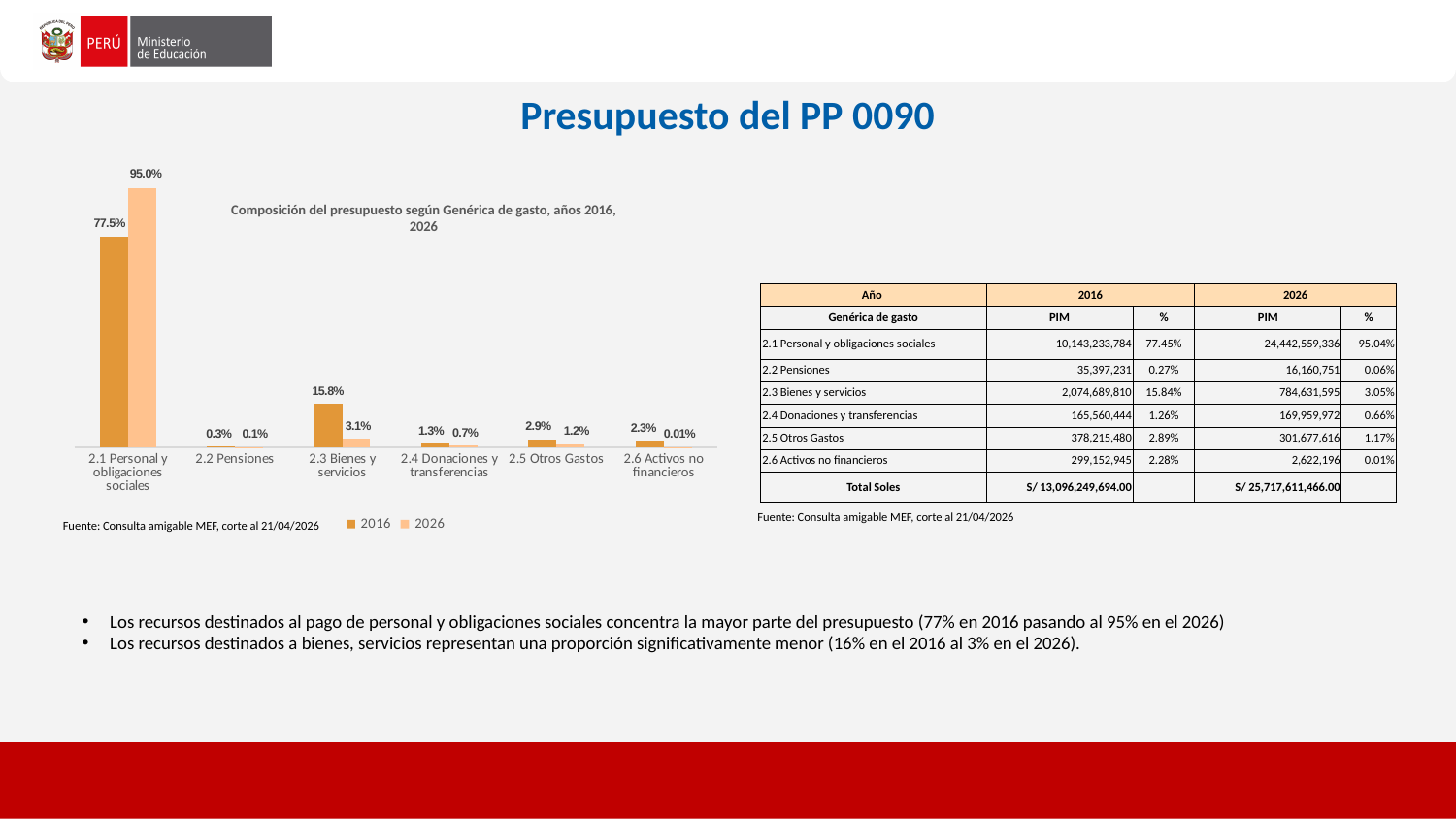
What is the 2016 value for 2.1 Personal y obligaciones sociales in the chart? 77.5% Which category has the highest 2026 value in the chart? 2.1 Personal y obligaciones sociales How many series does the chart legend list? 2 How many categories are shown on the x axis of the chart? 6 Which is larger for 2.3 Bienes y servicios: the 2016 value or the 2026 value? 2016 What is the 2026 value for 2.6 Activos no financieros in the chart? 0.01% What is the 2016 value for 2.3 Bienes y servicios in the chart? 15.8% What is the 2026 value for 2.1 Personal y obligaciones sociales in the chart? 95.0% What is the title of the chart? Composición del presupuesto según Genérica de gasto, años 2016, 2026 What is the difference between the 2026 and 2016 values for 2.1 Personal y obligaciones sociales? 17.5% Which category has the lowest 2016 value in the chart? 2.2 Pensiones What kind of chart is shown on the slide? Bar chart